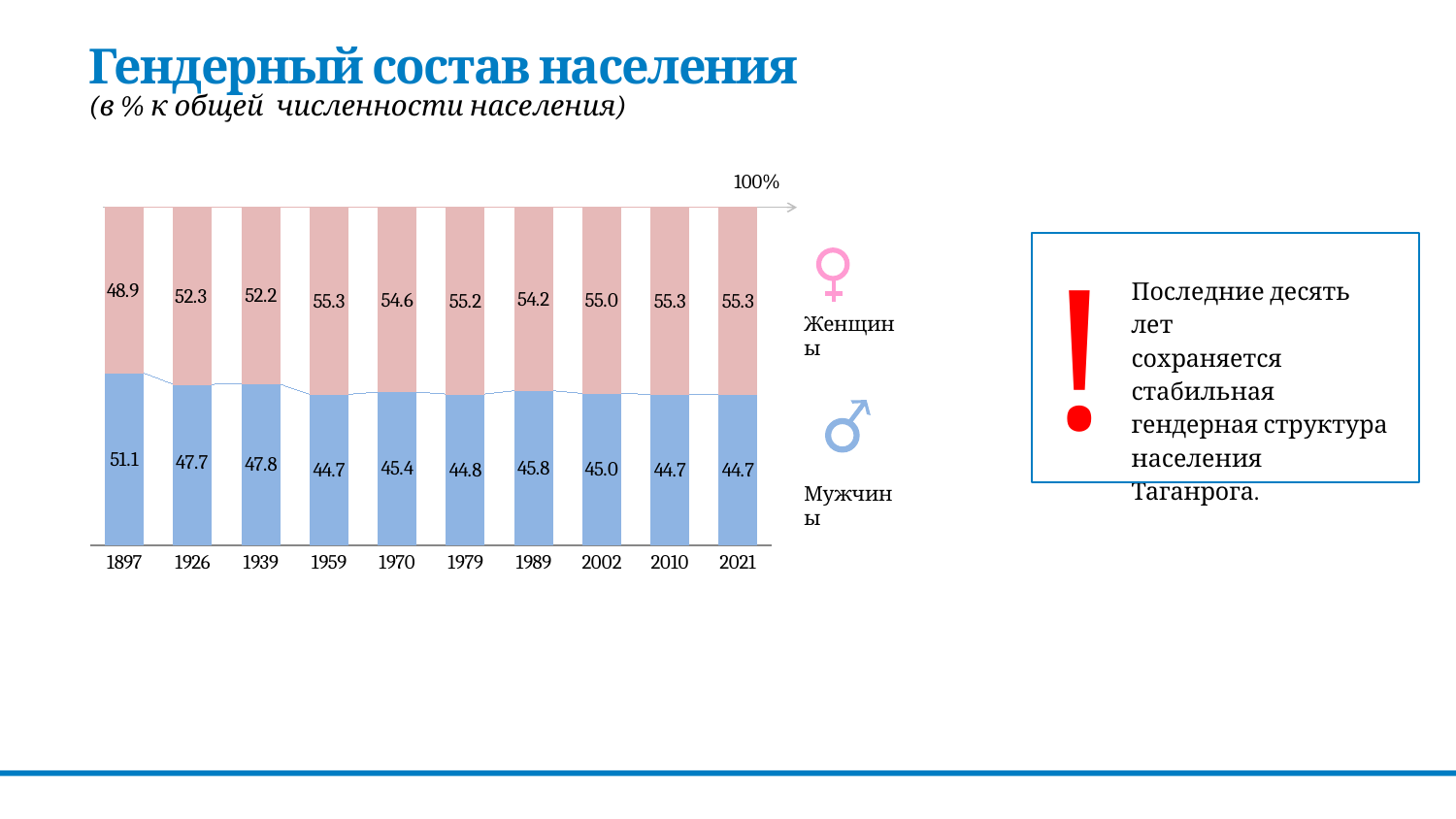
Which was larger in 1939, the share of women or the share of men? women Which colour represents women in the chart? pink What is the total of the stacked bar for 1989? 100.0 In which year was the share of men the highest? 1897 What share of the population was women in 1897? 48.9 What share of the population was men in 2021? 44.7 In which year was the share of women the lowest? 1897 What is the value for women in 1970? 54.6 How many series does the chart show? 2 What kind of chart is shown on the slide? stacked bar chart How many years are shown on the x axis? 10 What is the difference between the women's and men's shares in 2002? 10.0